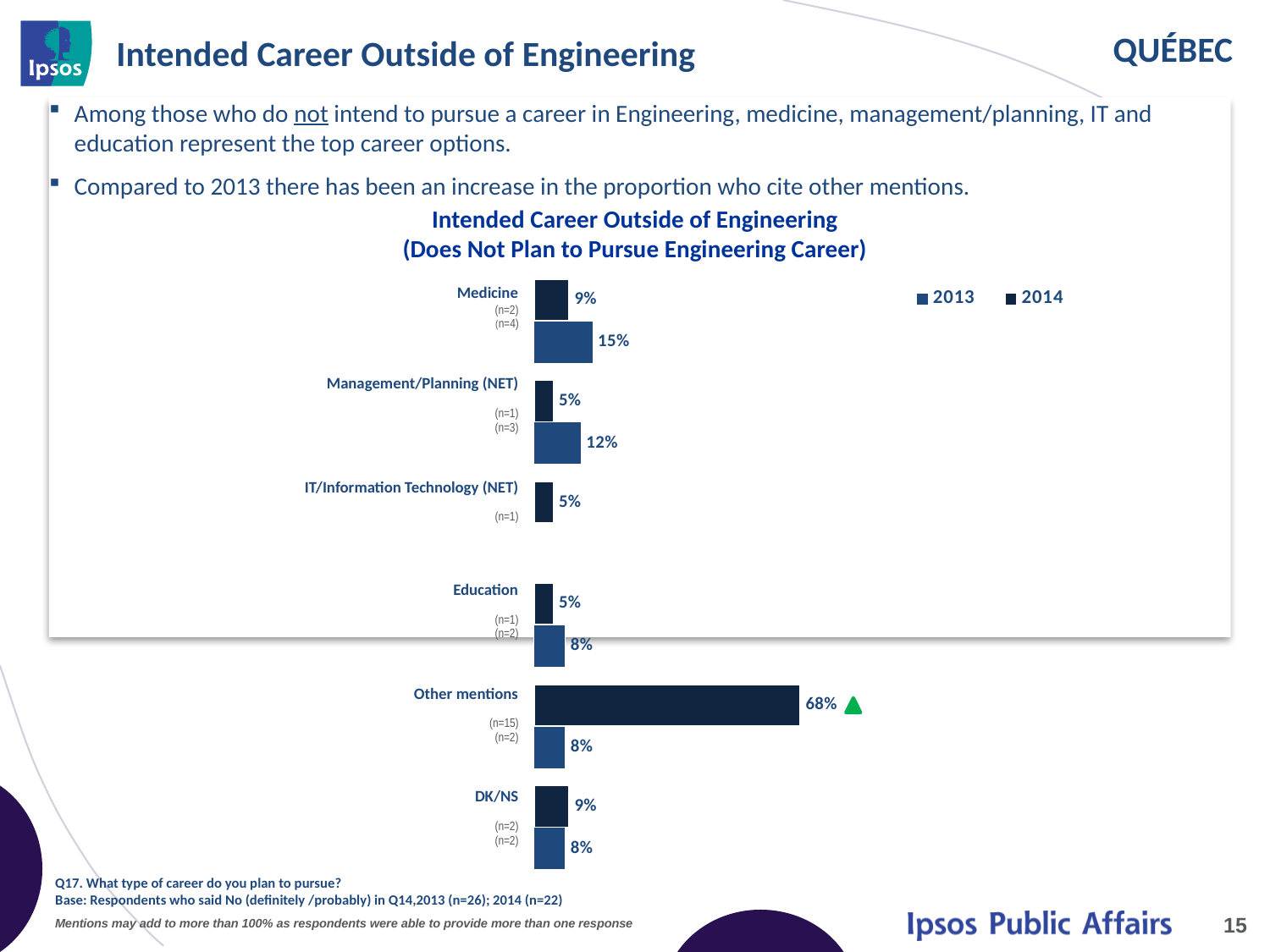
What is the 2014 value for Medicine? 9% How many categories are shown on the chart? 6 What is the 2013 value for Education? 8% What is the difference between the 2013 and 2014 values for Other mentions? 60 percentage points What is the difference between the 2014 and 2013 values for Medicine? 6 percentage points Which category has the highest 2014 value? Other mentions Which category has the highest 2013 value? Medicine What type of chart is shown on the slide? Bar chart What is the 2013 value for Other mentions? 8% Which is larger for Management/Planning (NET): the 2013 value or the 2014 value? 2013 How many series does the legend list? 2 What is the 2014 value for Management/Planning (NET)? 5%